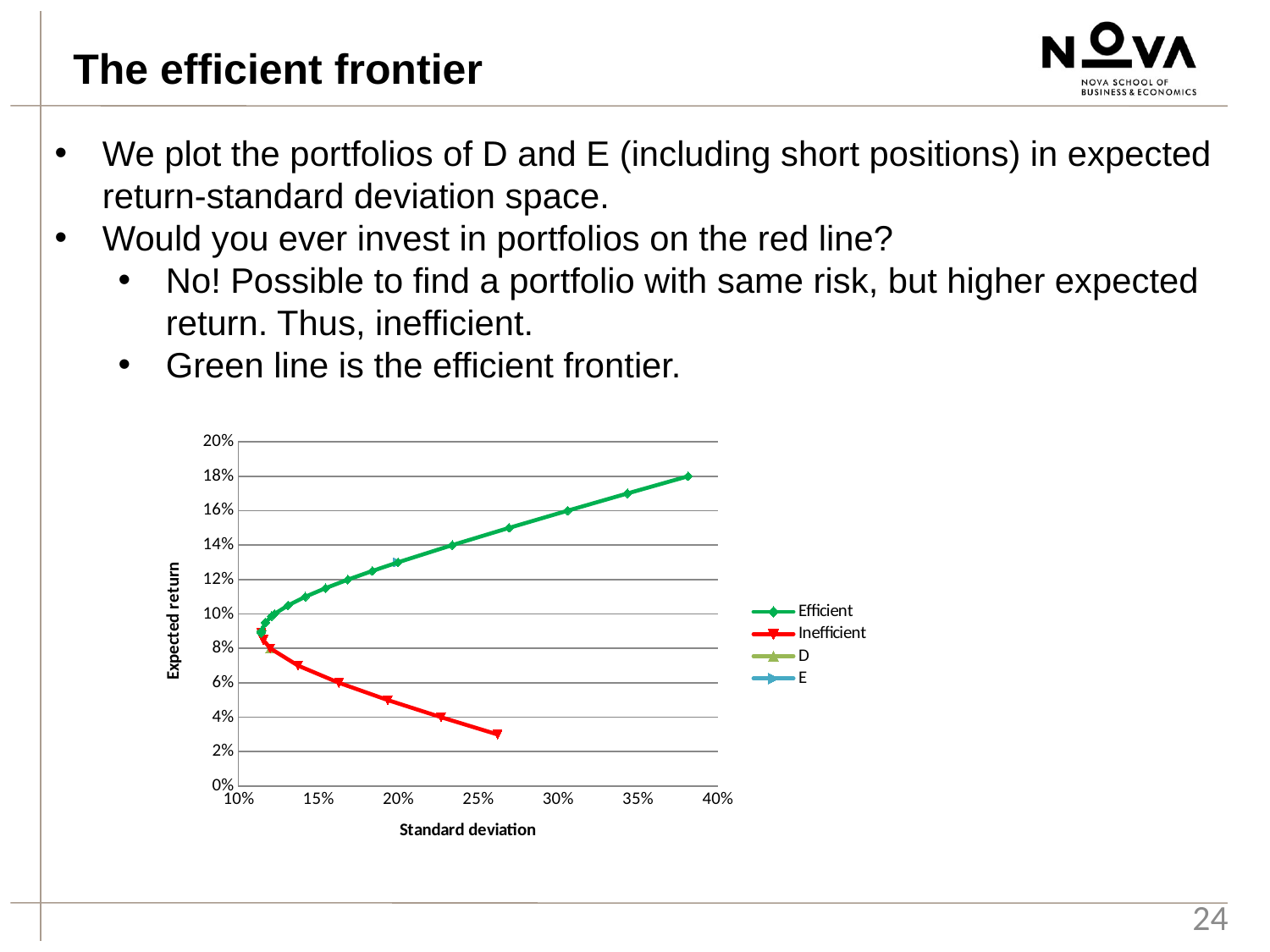
Is the largest standard deviation on the Efficient line greater or less than 35%? greater What colour is the Inefficient line in the chart? red What kind of chart is shown on the slide? line chart How many series does the chart's legend list? 4 Is the largest standard deviation on the Inefficient line greater or less than 30%? less Along the Efficient line, does expected return rise or fall as standard deviation increases? rise Along the Inefficient line, does expected return rise or fall as standard deviation increases? fall Is the expected return at the point where the Efficient and Inefficient lines meet greater or less than 12%? less What are the entries in the chart's legend? Efficient, Inefficient, D, E Which series reaches a higher expected return, Efficient or Inefficient? Efficient